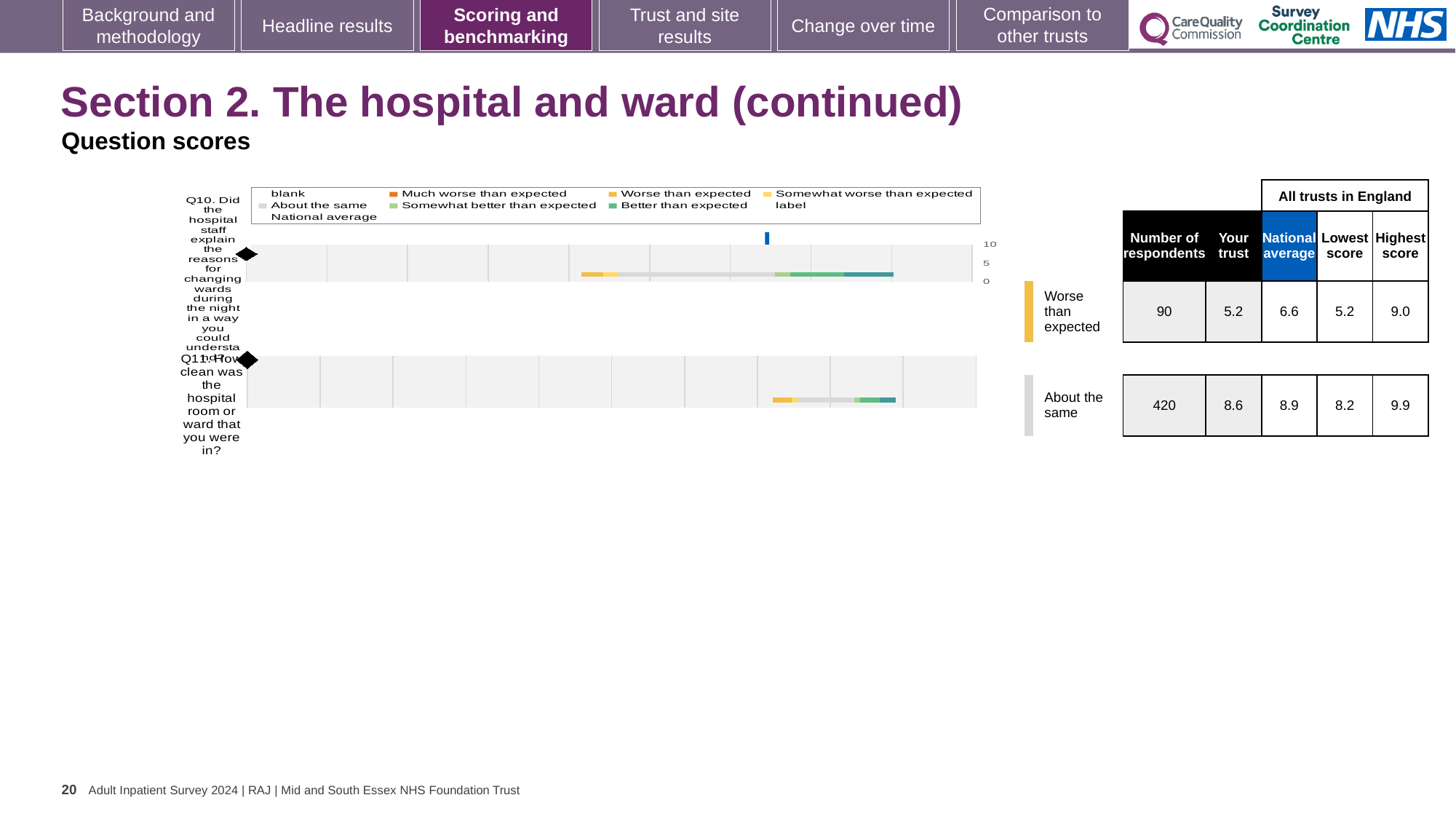
Which question has the higher 'Your trust' score, Q10 or Q11? Q11 Which is larger for Q10: the trust's score or the national average? National average What is the difference between the national average and the trust's score for Q10? 1.4 What is the 'Your trust' score for Q11 (how clean was the hospital room or ward)? 8.6 What is the 'Your trust' score for Q10 (explaining reasons for changing wards during the night)? 5.2 What is the highest score among all trusts in England for Q11? 9.9 Which benchmark category is Q11 rated as for this trust? About the same Which benchmark category is Q10 rated as for this trust? Worse than expected What is the national average score for Q10? 6.6 How many questions are plotted in the question scores chart? 2 What kind of chart is used to show the question scores for Q10 and Q11? bar chart How many respondents answered Q11? 420